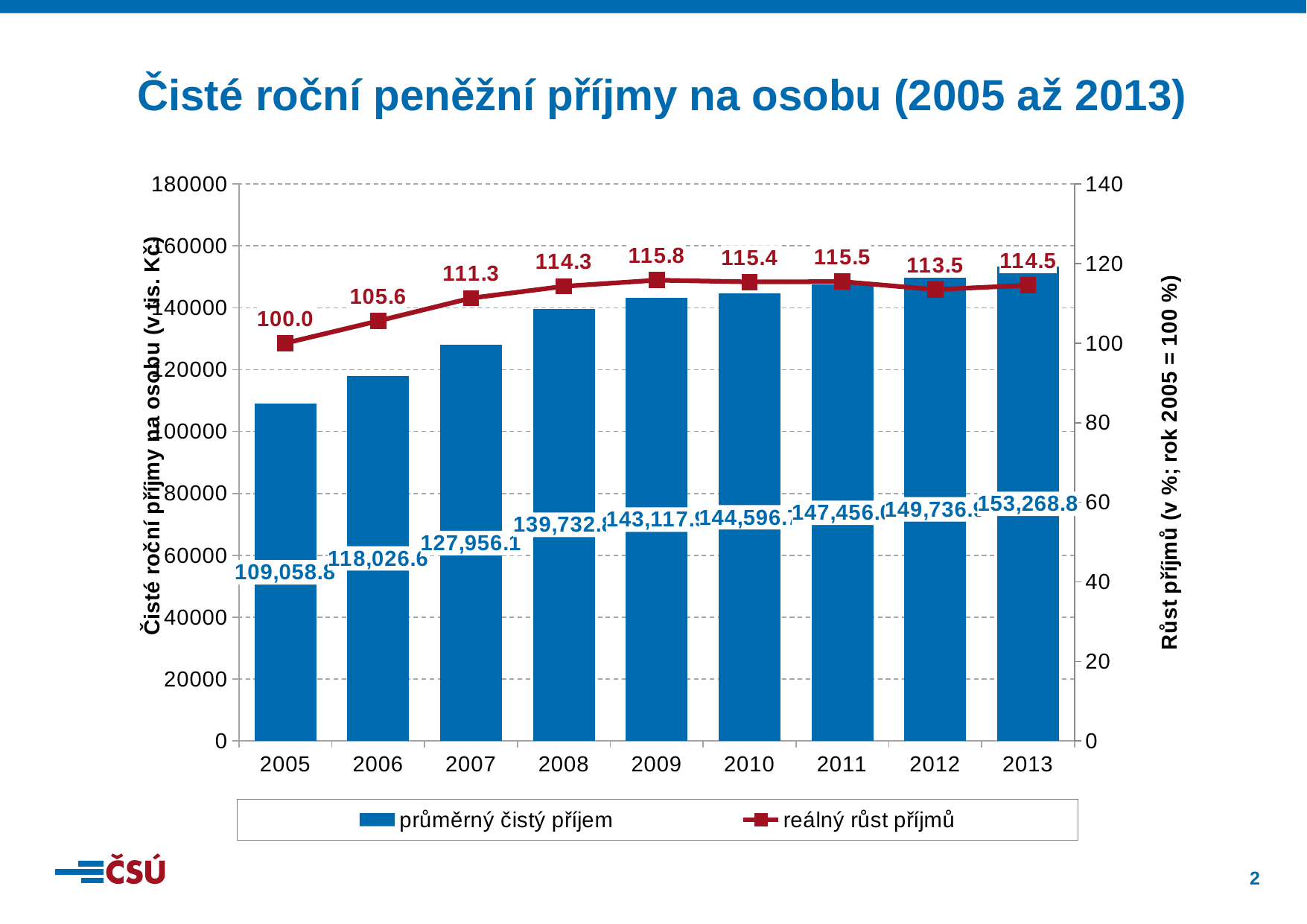
Is the value of průměrný čistý příjem for 2008 greater or less than 120000? greater By how much did reálný růst příjmů increase from 2006 to 2007? 5.7 In which year is reálný růst příjmů the highest? 2009 In which year is reálný růst příjmů the lowest? 2005 How many years are shown on the x axis? 9 How many series does the legend list? 2 What is the value of reálný růst příjmů for 2009? 115.8 What is the difference between průměrný čistý příjem in 2013 and in 2005? 44,210.0 What is the value of průměrný čistý příjem for 2005? 109,058.8 Which year has the higher reálný růst příjmů, 2012 or 2013? 2013 What is the value of reálný růst příjmů for 2012? 113.5 What is the value of průměrný čistý příjem for 2013? 153,268.8